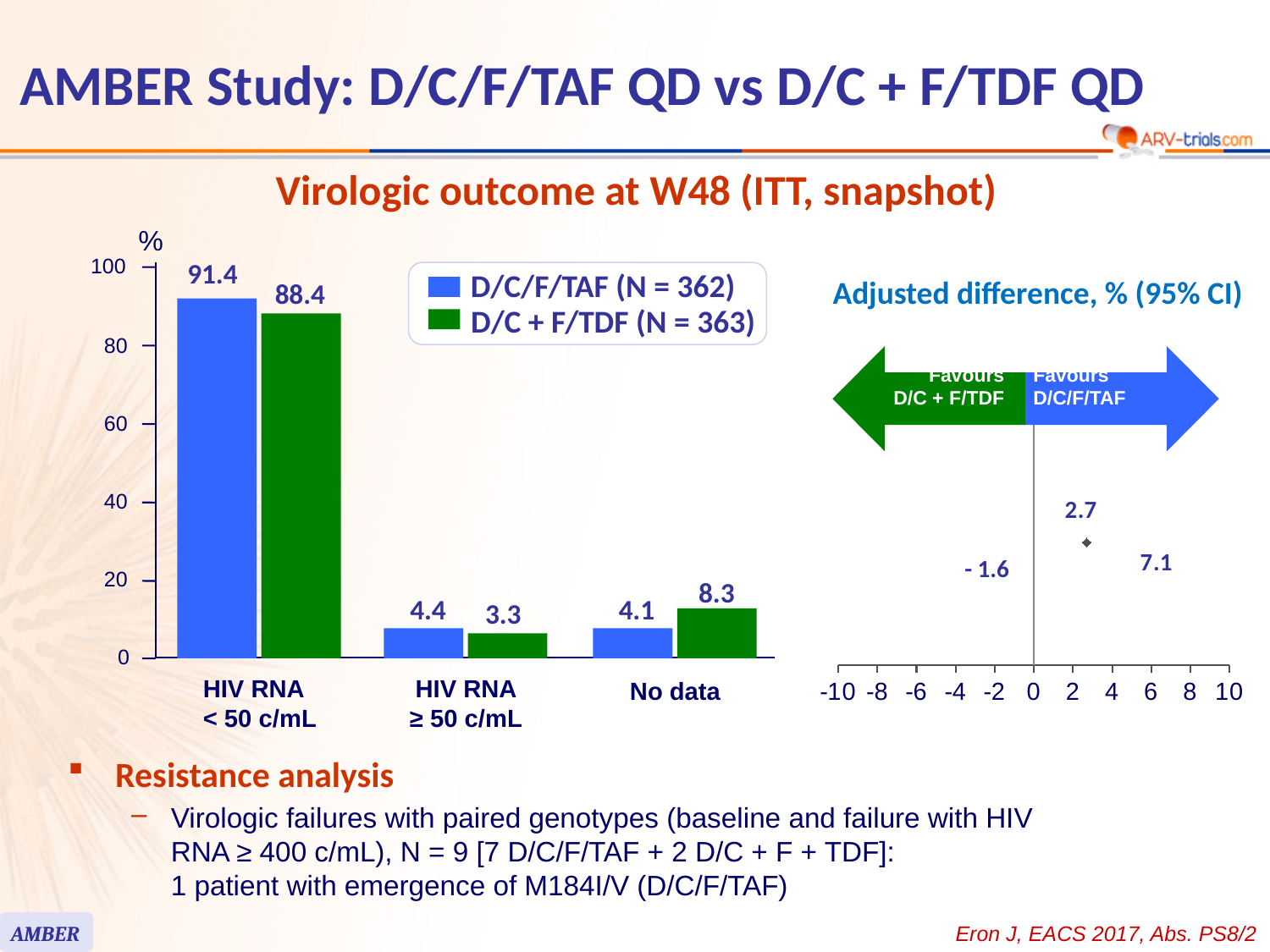
In the 'Virologic outcome at W48 (ITT, snapshot)' bar chart, which category has the highest value for D/C/F/TAF? HIV RNA < 50 c/mL In the 'Virologic outcome at W48 (ITT, snapshot)' bar chart, which series has the larger value in the No data category? D/C + F/TDF In the 'Virologic outcome at W48 (ITT, snapshot)' bar chart, what is the difference between D/C/F/TAF and D/C + F/TDF in the HIV RNA < 50 c/mL category? 3.0 In the 'Virologic outcome at W48 (ITT, snapshot)' bar chart, which category has the lowest value for D/C + F/TDF? HIV RNA ≥ 50 c/mL In the 'Virologic outcome at W48 (ITT, snapshot)' bar chart, what is the value for D/C/F/TAF in the HIV RNA < 50 c/mL category? 91.4 How many series does the legend of the 'Virologic outcome at W48 (ITT, snapshot)' chart list? 2 How many categories are shown on the x axis of the 'Virologic outcome at W48 (ITT, snapshot)' bar chart? 3 In the 'Virologic outcome at W48 (ITT, snapshot)' bar chart, is the value for D/C + F/TDF in the HIV RNA < 50 c/mL category greater or less than 80? greater In the 'Adjusted difference, % (95% CI)' chart on the right, what is the adjusted difference point estimate? 2.7 In the 'Virologic outcome at W48 (ITT, snapshot)' bar chart, what is the value for D/C + F/TDF in the HIV RNA ≥ 50 c/mL category? 3.3 In the 'Virologic outcome at W48 (ITT, snapshot)' bar chart, what is the value for D/C + F/TDF in the No data category? 8.3 What kind of chart is the 'Virologic outcome at W48 (ITT, snapshot)' chart? Bar chart